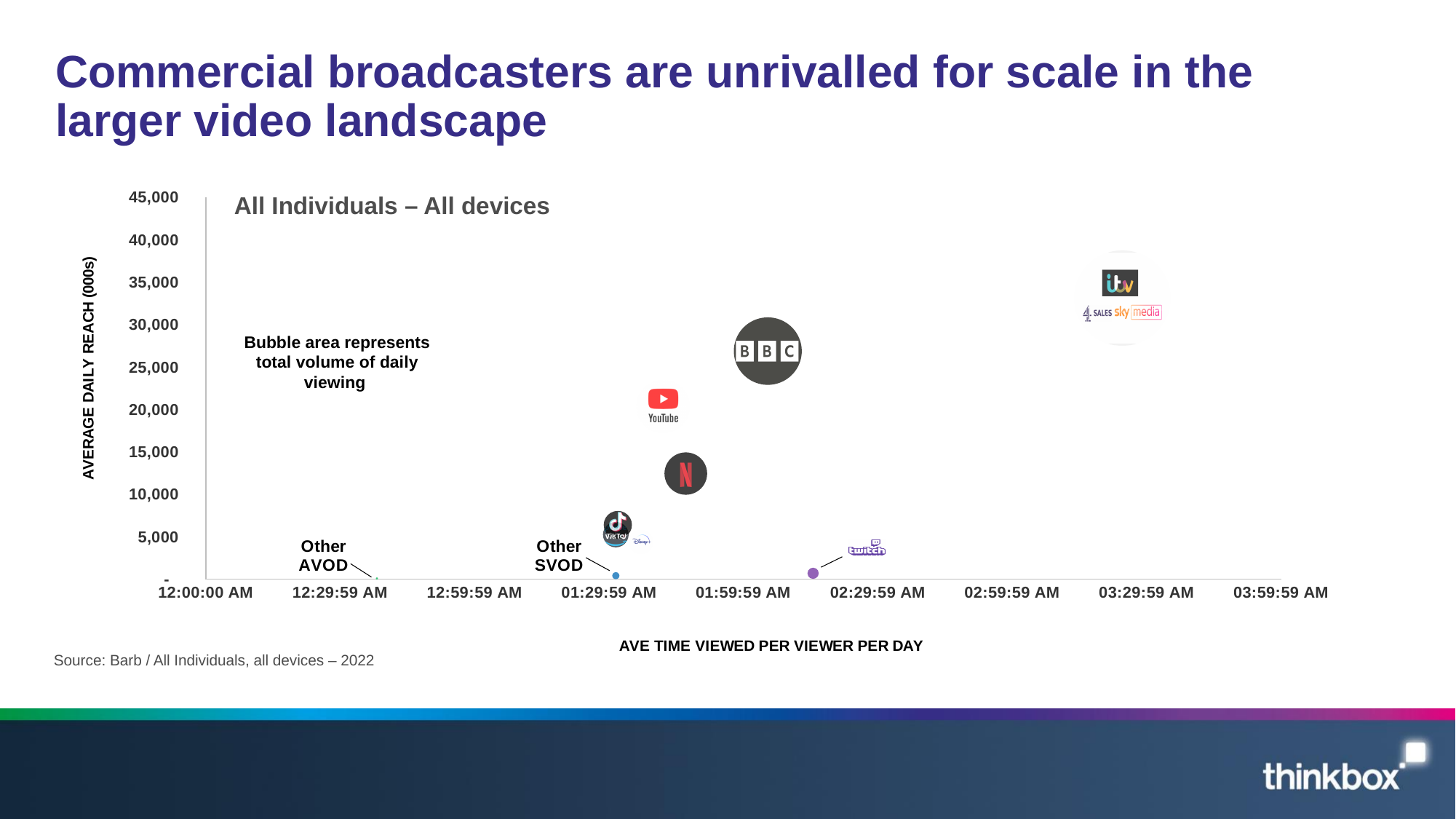
Which bubble has the highest average daily reach? Commercial broadcasters (ITV / 4 Sales / Sky Media) According to the note on the chart, what does the bubble area represent? Total volume of daily viewing Is the average daily reach for Twitch greater or less than 5,000? less Which has the higher average daily reach, BBC or Netflix? BBC Which has the higher average daily reach, YouTube or Netflix? YouTube Is the average daily reach for Netflix greater or less than 15,000? less What is the subtitle printed inside the chart area? All Individuals – All devices What kind of chart is shown on the slide? Bubble chart Which bubble is furthest to the right, i.e. has the highest average time viewed per viewer per day? Commercial broadcasters (ITV / 4 Sales / Sky Media) Is the average daily reach for BBC greater or less than 25,000? greater Which has the higher average time viewed per viewer per day, BBC or YouTube? BBC